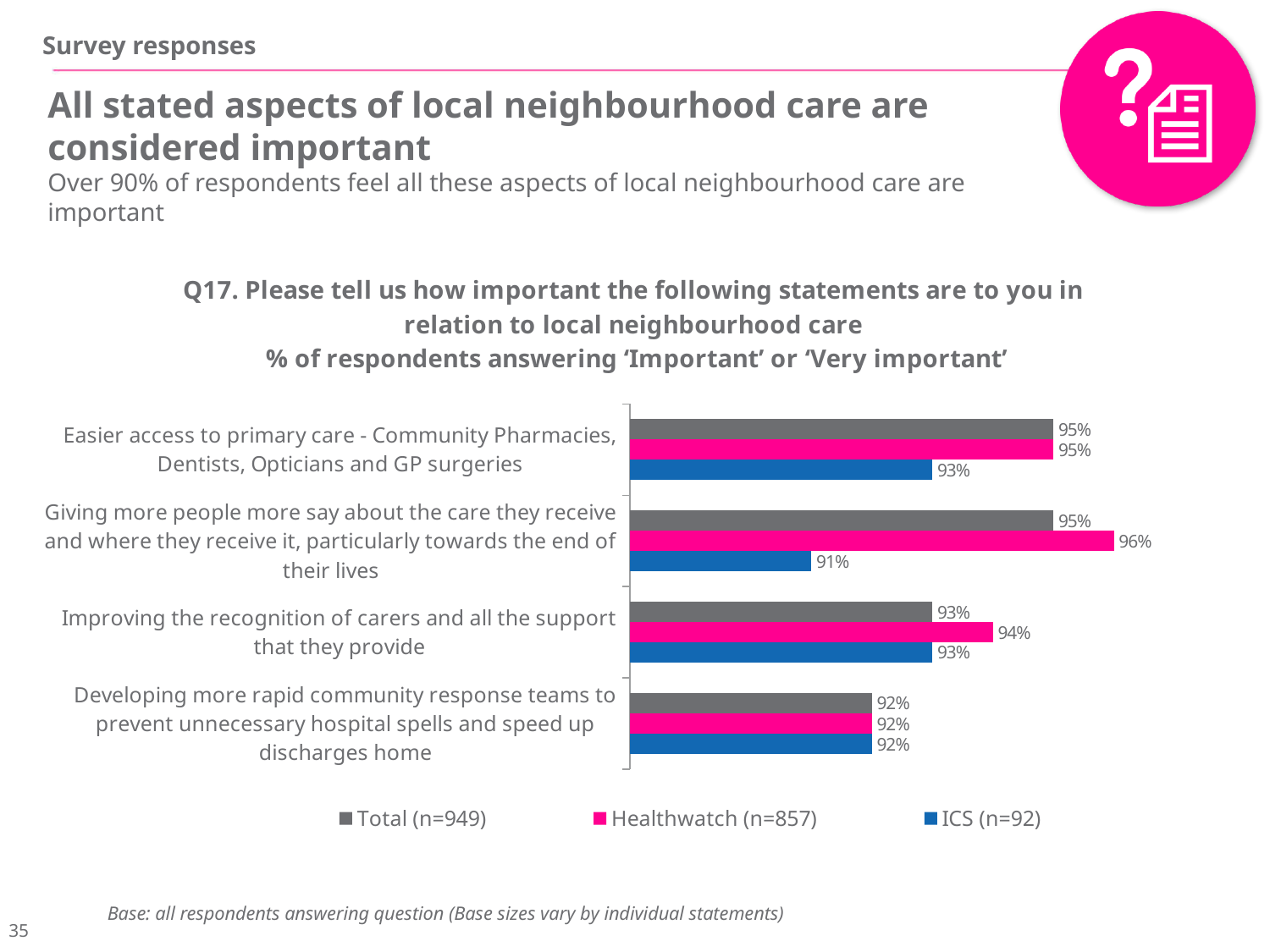
What is the Total value for 'Improving the recognition of carers and all the support that they provide'? 93% What is the difference between the Healthwatch and ICS values for 'Giving more people more say about the care they receive and where they receive it, particularly towards the end of their lives'? 5 percentage points What is the sample size (n) for the Healthwatch series shown in the legend? 857 Which statement has the lowest ICS value? Giving more people more say about the care they receive and where they receive it, particularly towards the end of their lives Which statement has the highest Healthwatch value? Giving more people more say about the care they receive and where they receive it, particularly towards the end of their lives How many statements (categories) are shown in the chart? 4 What percentage of Healthwatch respondents rated 'Giving more people more say about the care they receive and where they receive it, particularly towards the end of their lives' as important or very important? 96% What is the ICS value for 'Easier access to primary care - Community Pharmacies, Dentists, Opticians and GP surgeries'? 93% How many series does the legend list? 3 What kind of chart is shown on the slide? Bar chart For 'Improving the recognition of carers and all the support that they provide', which is larger: the Healthwatch value or the ICS value? Healthwatch Which colour represents the ICS series in the chart? Blue